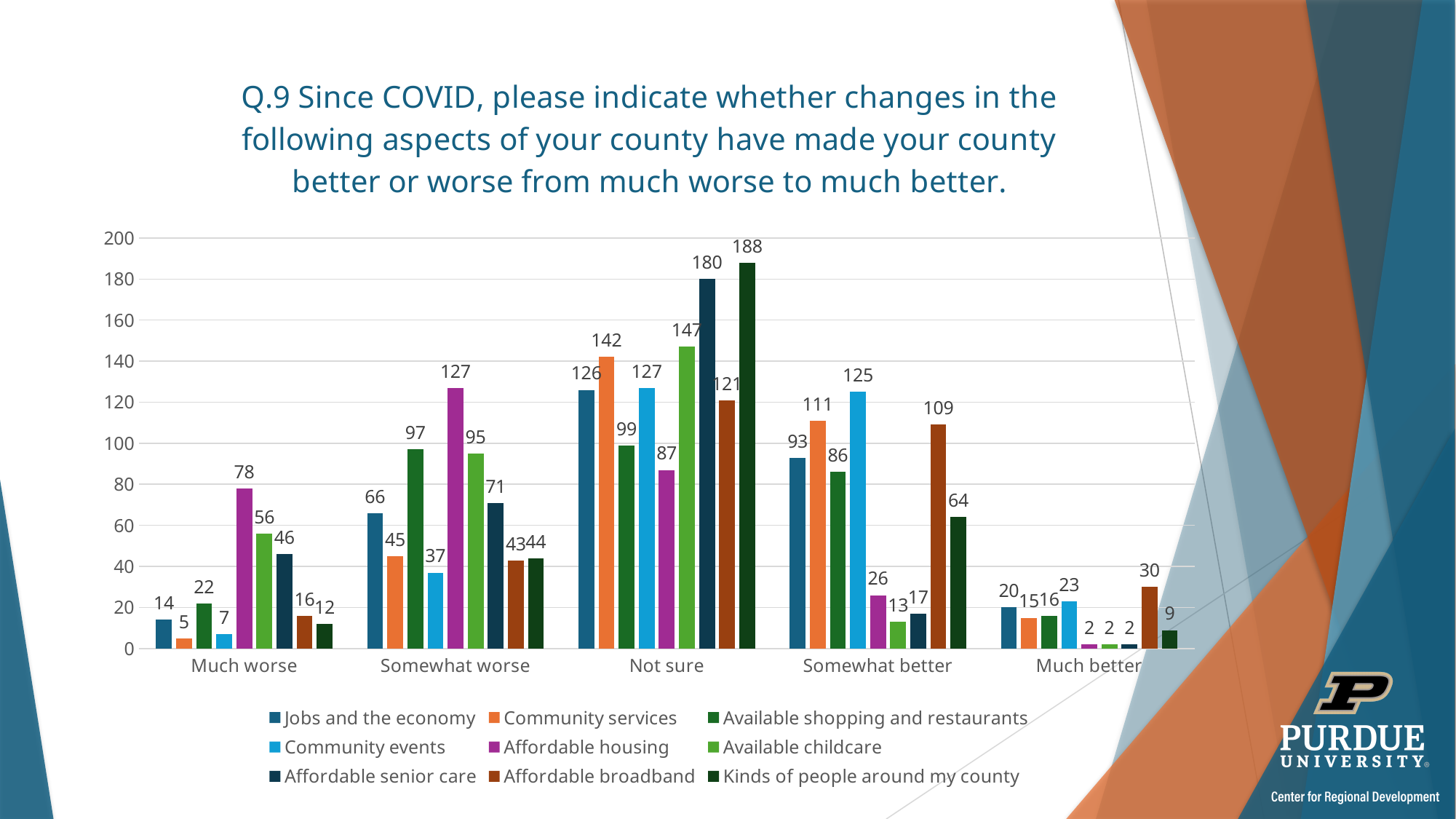
What is the value for Affordable broadband in the Somewhat better category? 109 Which series has the lowest value in the Much worse category? Community services Which category has the highest value for Jobs and the economy? Not sure How many series does the legend list? 9 What is the value for Available childcare in the Much better category? 2 What is the value for Affordable housing in the Much worse category? 78 How many categories are shown on the x axis? 5 What kind of chart is shown on the slide? Bar chart Which series has the highest value in the Somewhat worse category? Affordable housing What is the difference between Affordable senior care and Affordable housing in the Not sure category? 93 In the Somewhat better category, which is larger: Community events or Community services? Community events What is the value for Kinds of people around my county in the Not sure category? 188